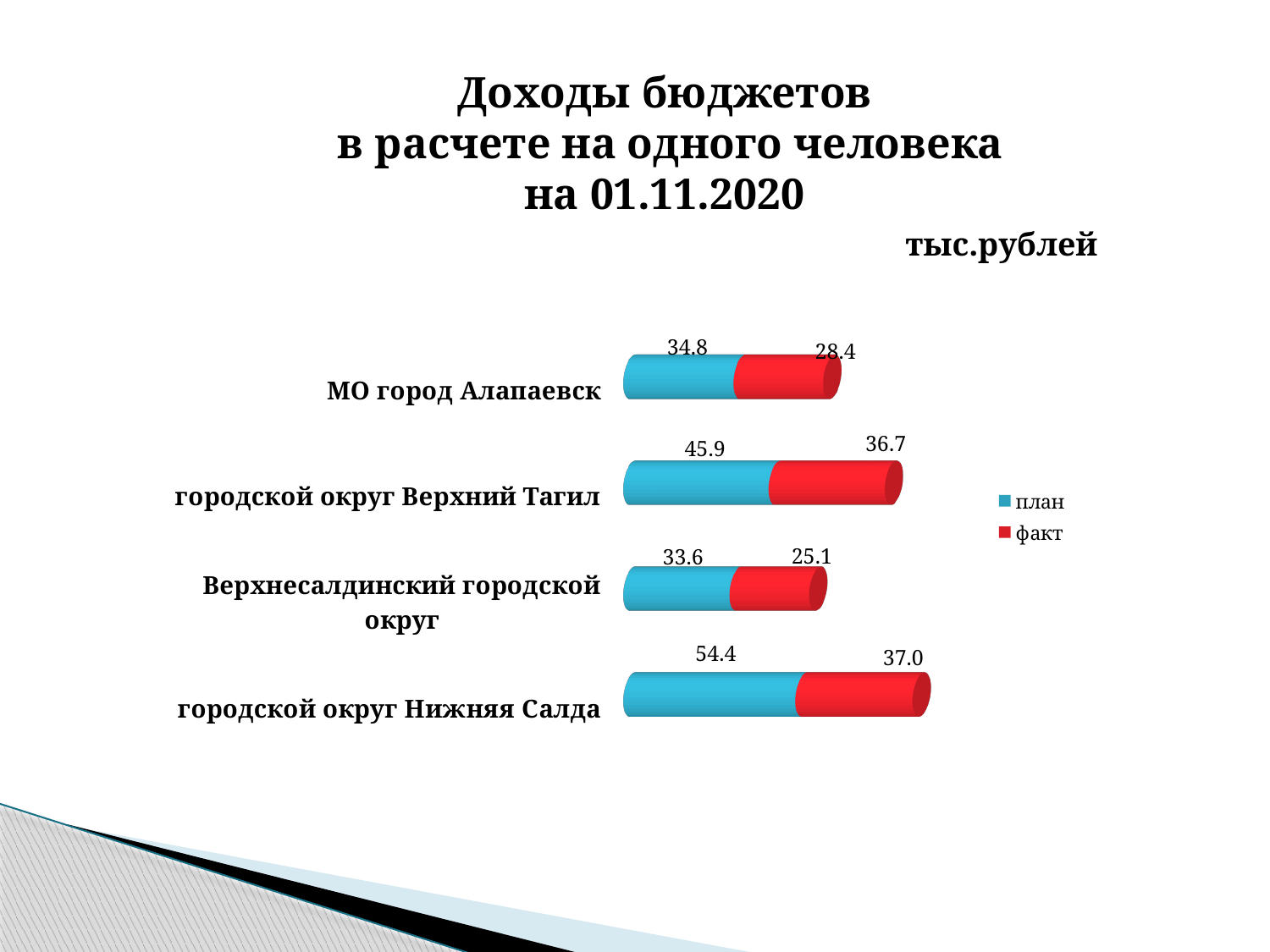
What kind of chart is shown on the slide? bar chart How many series does the legend list? 2 What is the difference between the план and факт values for городской округ Верхний Тагил? 9.2 What unit is stated for the values in the chart? тыс.рублей Which is larger: the план value for МО город Алапаевск or the план value for Верхнесалдинский городской округ? МО город Алапаевск Which category has the lowest факт value? Верхнесалдинский городской округ Which category has the highest план value? городской округ Нижняя Салда What is the план value for городской округ Нижняя Салда? 54.4 What is the total of the stacked bar for городской округ Нижняя Салда? 91.4 How many categories are shown in the chart? 4 What is the факт value for МО город Алапаевск? 28.4 What is the факт value for городской округ Верхний Тагил? 36.7